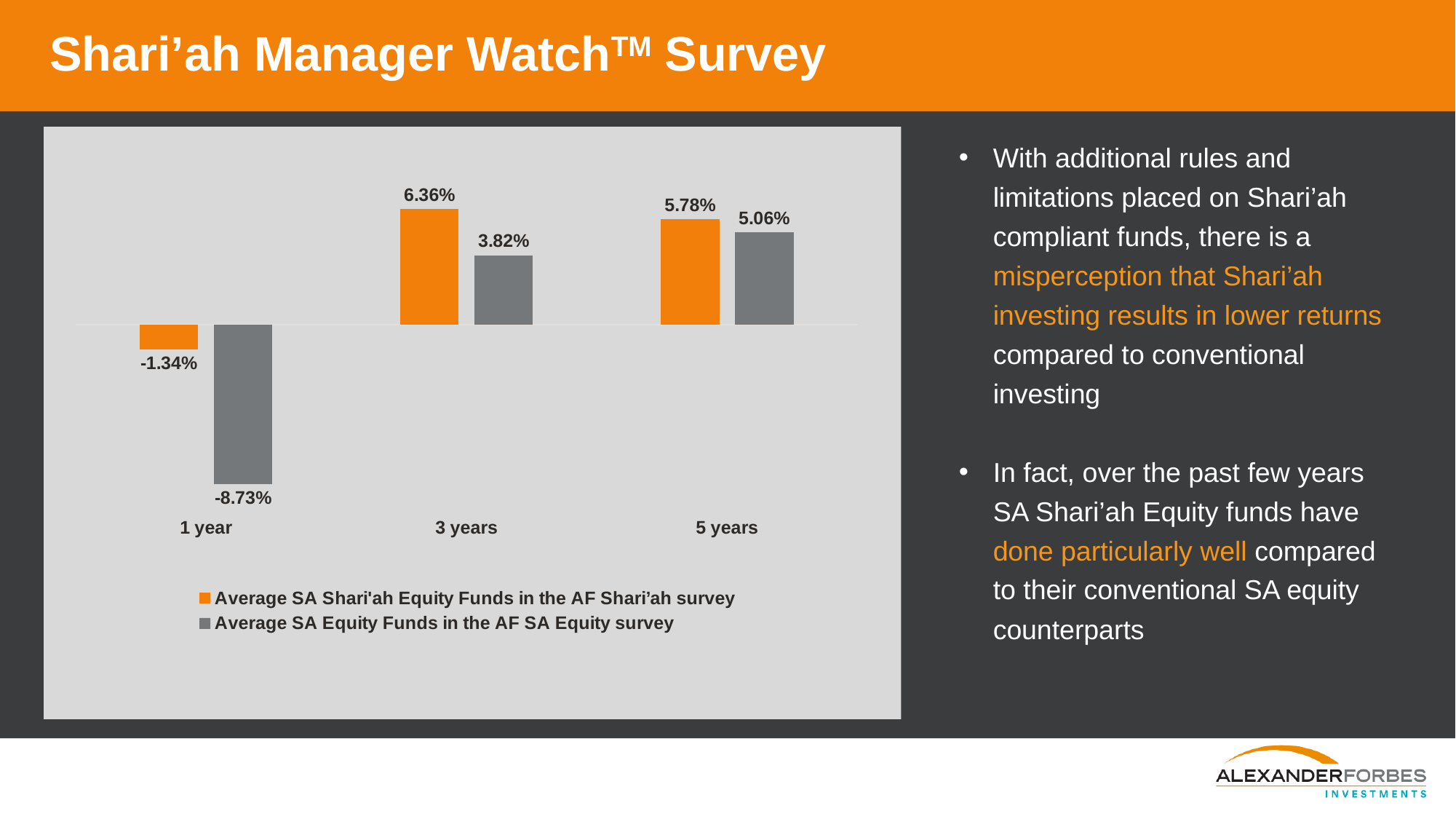
At 5 years, which series has the larger value? Average SA Shari'ah Equity Funds in the AF Shari'ah survey How many series does the legend list? 2 Which period has the lowest value for Average SA Equity Funds in the AF SA Equity survey? 1 year What is the value for Average SA Equity Funds in the AF SA Equity survey at 1 year? -8.73% What kind of chart is shown on the slide? Bar chart What colour are the bars for Average SA Equity Funds in the AF SA Equity survey? Grey Which period has the highest value for Average SA Shari'ah Equity Funds in the AF Shari'ah survey? 3 years What is the value for Average SA Equity Funds in the AF SA Equity survey at 5 years? 5.06% What is the value for Average SA Shari'ah Equity Funds in the AF Shari'ah survey at 1 year? -1.34% What is the value for Average SA Shari'ah Equity Funds in the AF Shari'ah survey at 3 years? 6.36% How many periods are shown on the x axis? 3 What is the difference between the two series at 3 years? 2.54%